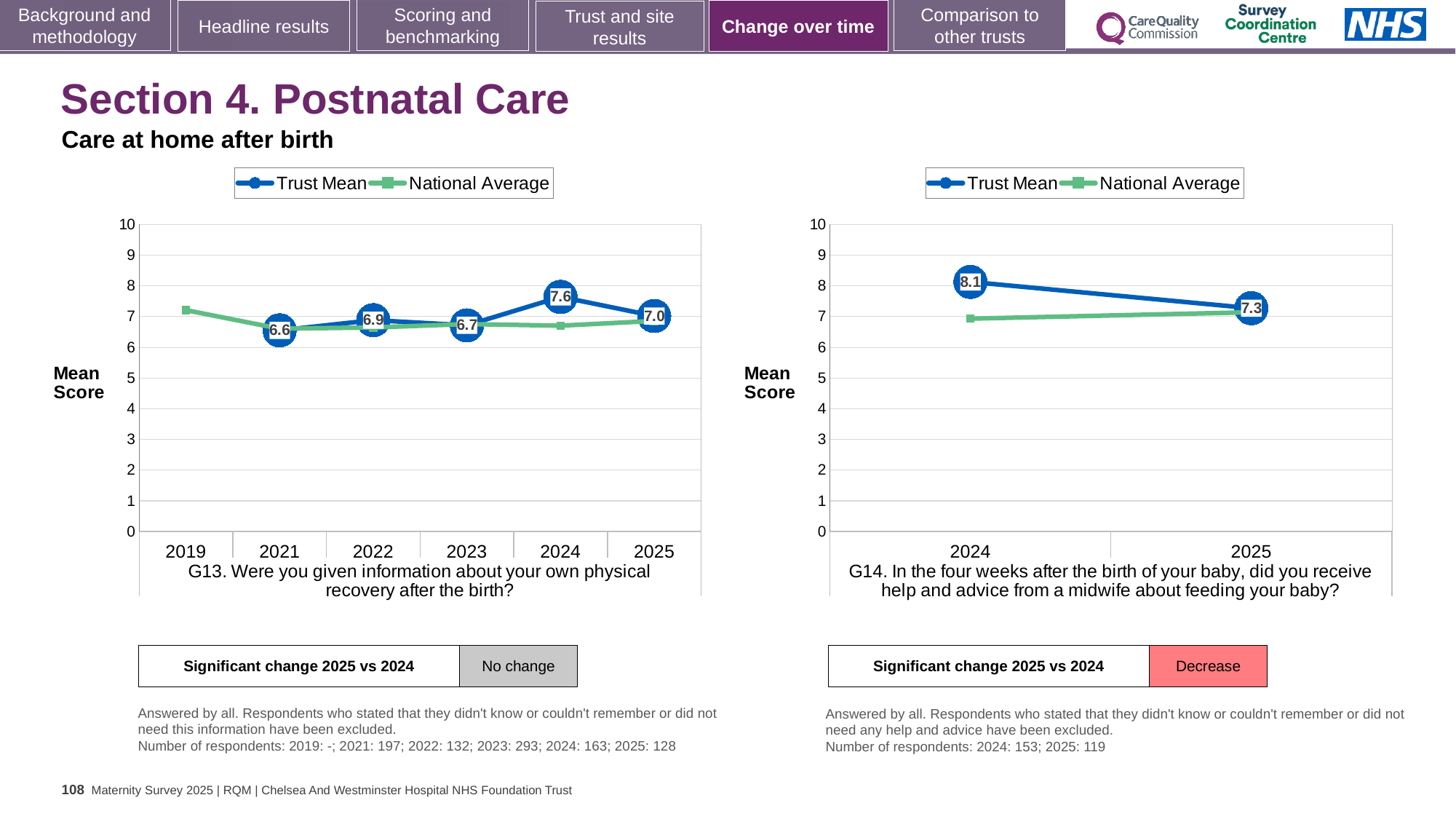
On the G14 chart, is the National Average value for 2024 greater or less than 8? less On the G14 chart, what is the difference between the Trust Mean scores for 2024 and 2025? 0.8 How many series does the legend of the G13 chart list? 2 On the G13 chart, what is the Trust Mean score for 2024? 7.6 What kind of chart is the G14 chart? Line chart On the G13 chart, is the Trust Mean score higher in 2022 or in 2023? 2022 On the G13 chart, which year has the highest Trust Mean score? 2024 On the G13 chart, what is the difference between the Trust Mean scores for 2024 and 2025? 0.6 On the G14 chart, what is the Trust Mean score for 2025? 7.3 How many years are shown on the x axis of the G14 chart? 2 On the G13 chart, what is the Trust Mean score for 2021? 6.6 On the G13 chart, which year has the lowest labelled Trust Mean score? 2021